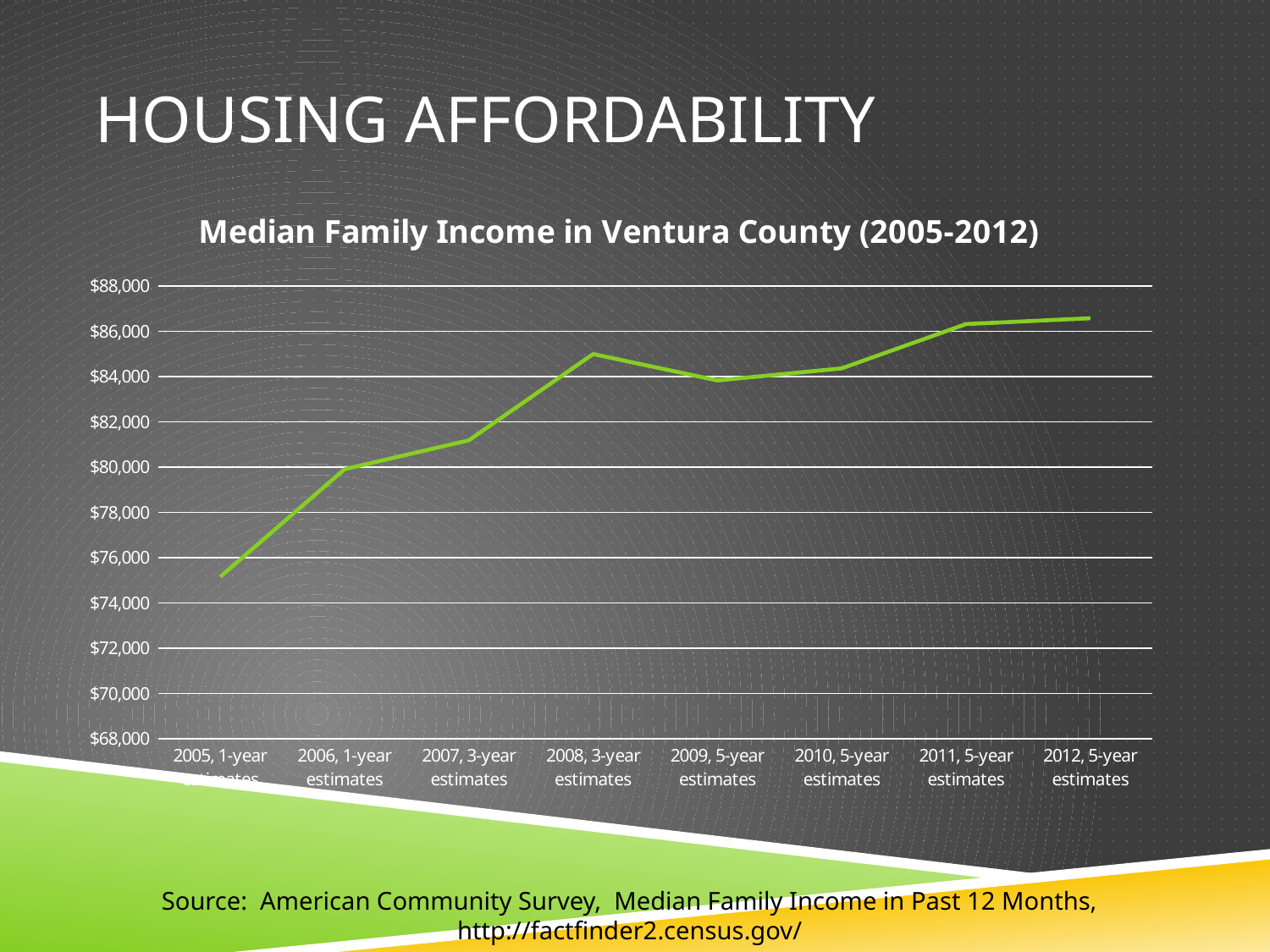
Which is larger, the value for 2011, 5-year estimates or 2008, 3-year estimates? 2011, 5-year estimates What kind of chart is shown on the slide? line chart Overall, does median family income rise or fall from 2005 to 2012? rise Is the value for 2008, 3-year estimates greater or less than $84,000? greater How many data points are plotted on the line? 8 What is the title of the chart? Median Family Income in Ventura County (2005-2012) Which is larger, the value for 2008, 3-year estimates or 2009, 5-year estimates? 2008, 3-year estimates Which year has the lowest median family income? 2005, 1-year estimates Is the value for 2005, 1-year estimates greater or less than $76,000? less Is the value for 2012, 5-year estimates greater or less than $86,000? greater